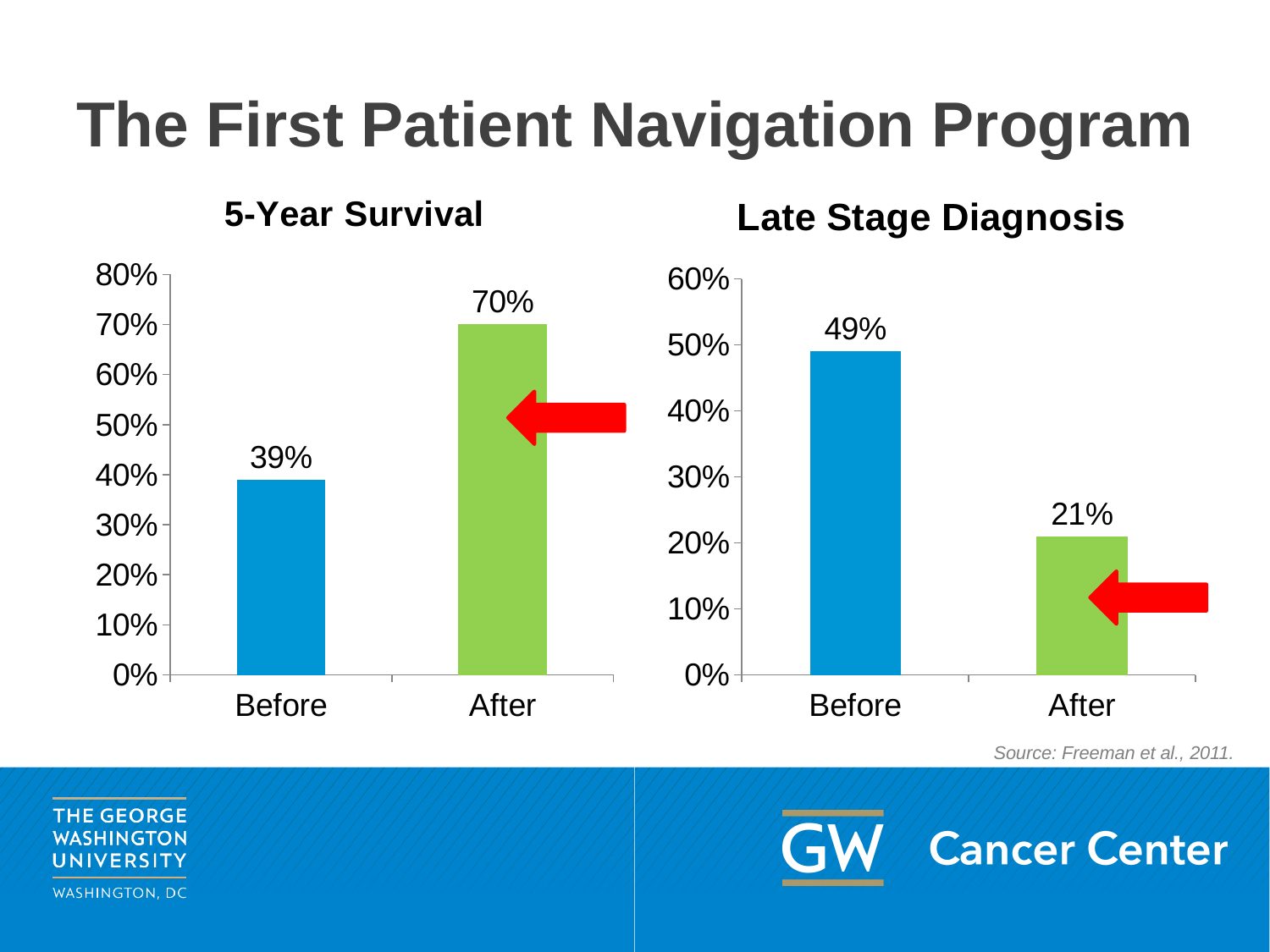
In the Late Stage Diagnosis chart, what is the value for After? 21% In the Late Stage Diagnosis chart, what is the difference between the Before and After values? 28% In the 5-Year Survival chart, do the values rise or fall from Before to After? rise In the Late Stage Diagnosis chart, which category has the lowest value? After In the 5-Year Survival chart, which category has the highest value? After In the 5-Year Survival chart, how many categories are shown on the x axis? 2 In the 5-Year Survival chart, what is the value for Before? 39% What kind of chart is the Late Stage Diagnosis chart? bar chart In the Late Stage Diagnosis chart, what is the value for Before? 49% In the 5-Year Survival chart, what is the difference between the After and Before values? 31% In the 5-Year Survival chart, what is the value for After? 70% In the Late Stage Diagnosis chart, is the value for Before larger or smaller than the value for After? larger